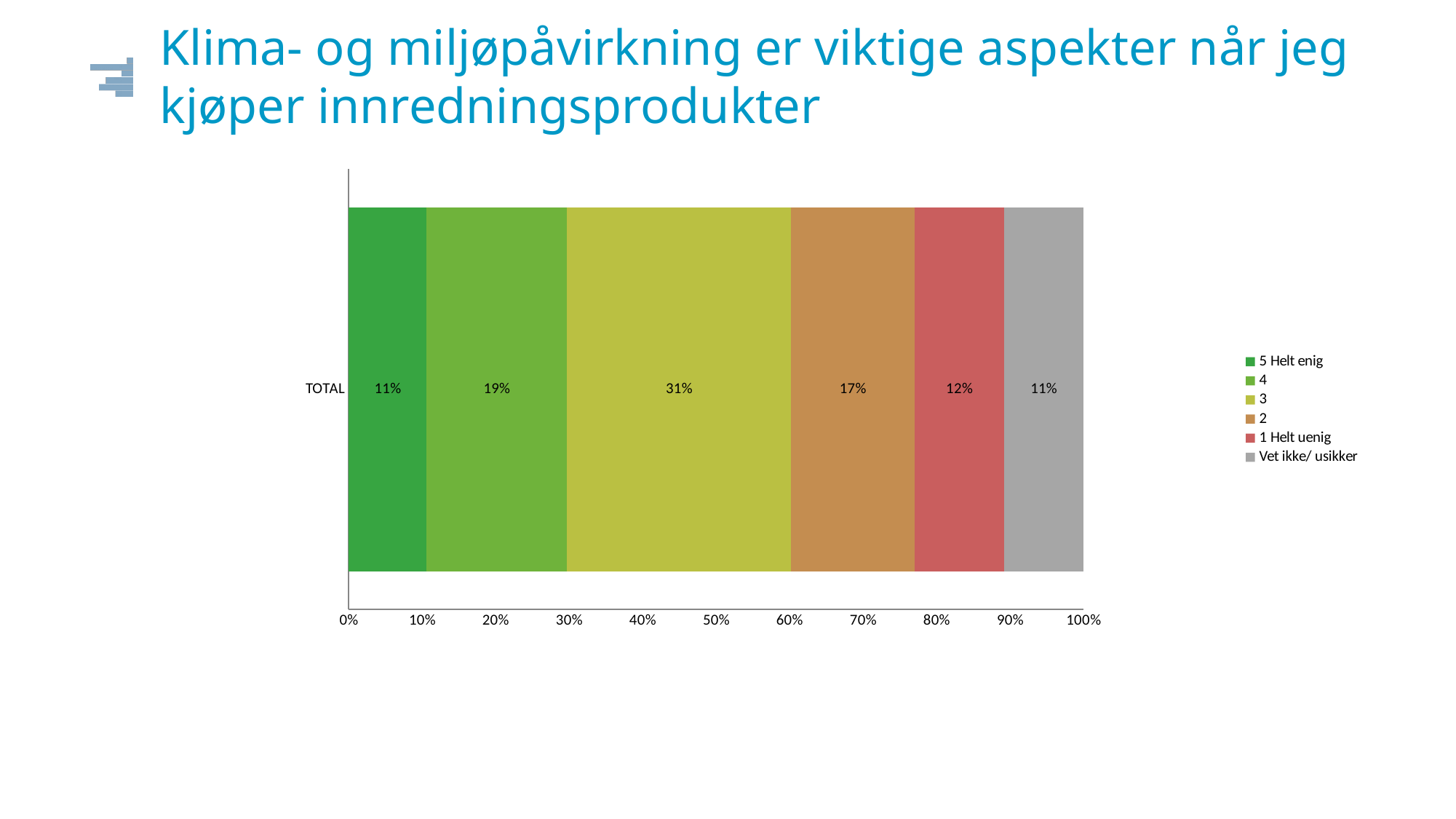
What is the label of the single category on the vertical axis? TOTAL What percentage of respondents answered "3"? 31% Which is larger: the share answering "2" or the share answering "1 Helt uenig"? 2 Is the share answering "3" greater or less than 30%? greater What kind of chart is shown on the slide? Stacked bar chart What percentage of respondents answered "5 Helt enig"? 11% What percentage of respondents answered "Vet ikke/ usikker"? 11% What is the difference between the share answering "4" and the share answering "2"? 2 percentage points Which response category has the largest share? 3 What percentage of respondents answered "1 Helt uenig"? 12% What is the combined share of respondents answering "5 Helt enig" and "4"? 30% How many series does the legend list? 6